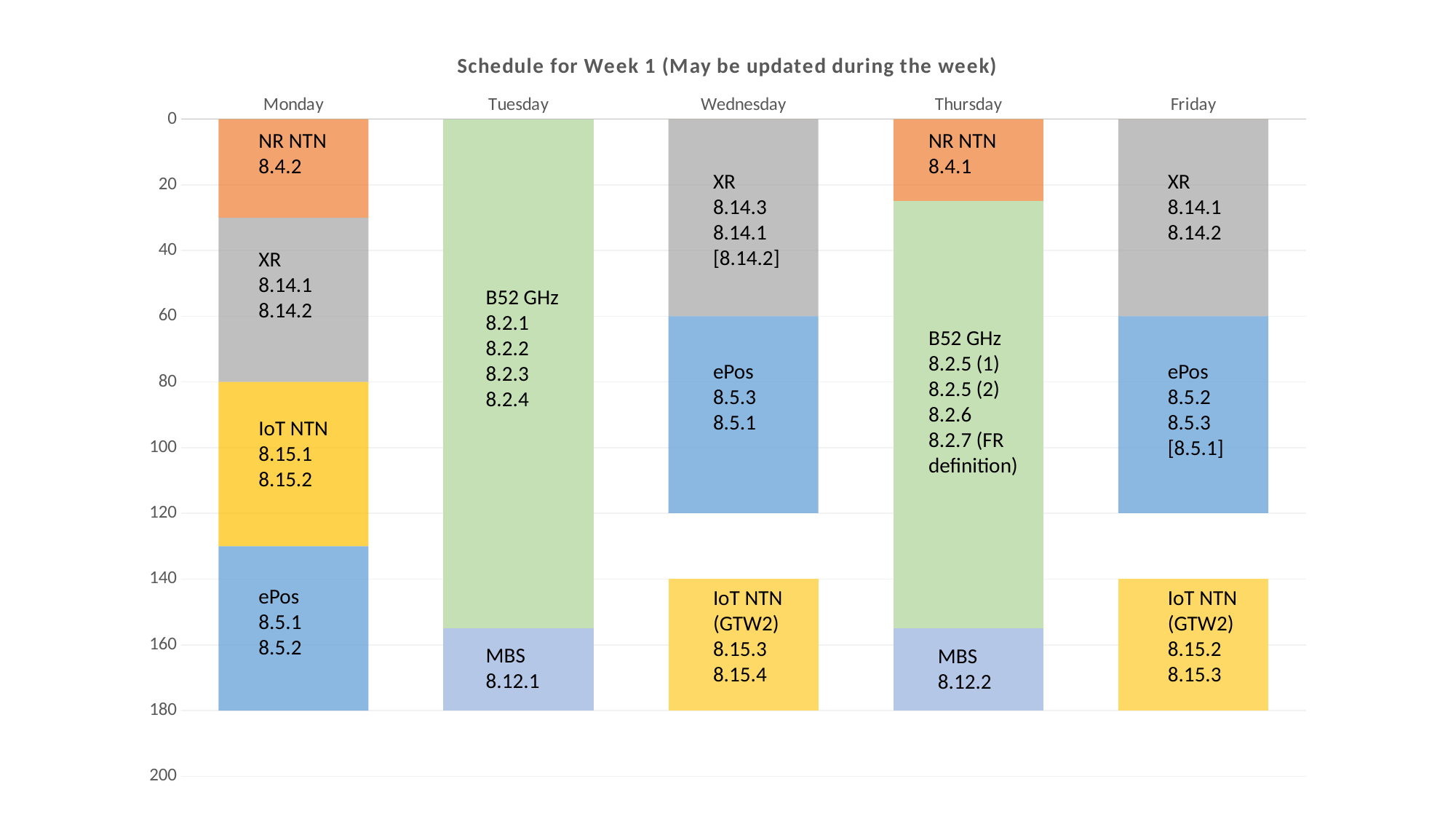
How many segments make up the Thursday bar? 3 What is the title of the chart? Schedule for Week 1 (May be updated during the week) On Tuesday, which segment is larger: B52 GHz or MBS? B52 GHz At what axis value does the XR segment on Wednesday end? 60 How many days (categories) are shown along the top of the chart? 5 Which topic occupies the top segment of the Monday bar? NR NTN What kind of chart is shown on the slide? Stacked bar chart Is the axis value where the NR NTN segment on Monday ends greater or less than 40? less Which agenda item is listed in the MBS segment on Tuesday? 8.12.1 On which day does the B52 GHz segment list items 8.2.1, 8.2.2, 8.2.3 and 8.2.4? Tuesday Which agenda item is listed in the MBS segment on Thursday? 8.12.2 At what axis value does the IoT NTN (GTW2) segment on Friday begin? 140